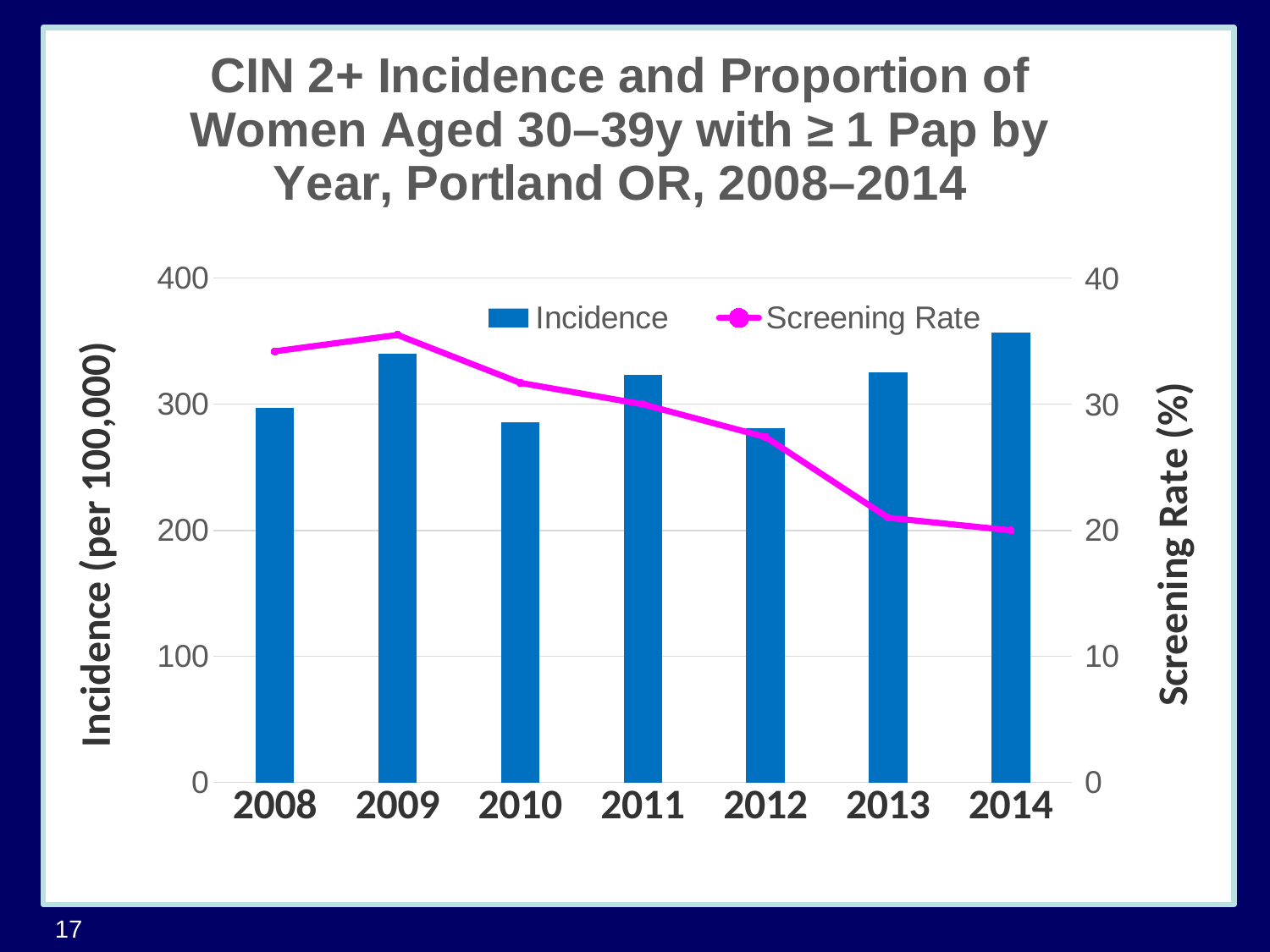
Is the Screening Rate for 2009 greater or less than 30? greater Which year has the larger Incidence bar, 2009 or 2010? 2009 Is the Incidence value for 2012 greater or less than 300? less What kind of chart is shown on the slide? Combination bar and line chart What is the label of the right-hand vertical axis? Screening Rate (%) How many series does the chart's legend list? 2 How many years are shown on the x axis of the chart? 7 Is the Screening Rate for 2012 greater or less than 30? less Does the Screening Rate generally rise or fall from 2009 to 2014? fall In which year is the Screening Rate highest? 2009 Which year has the highest Incidence bar? 2014